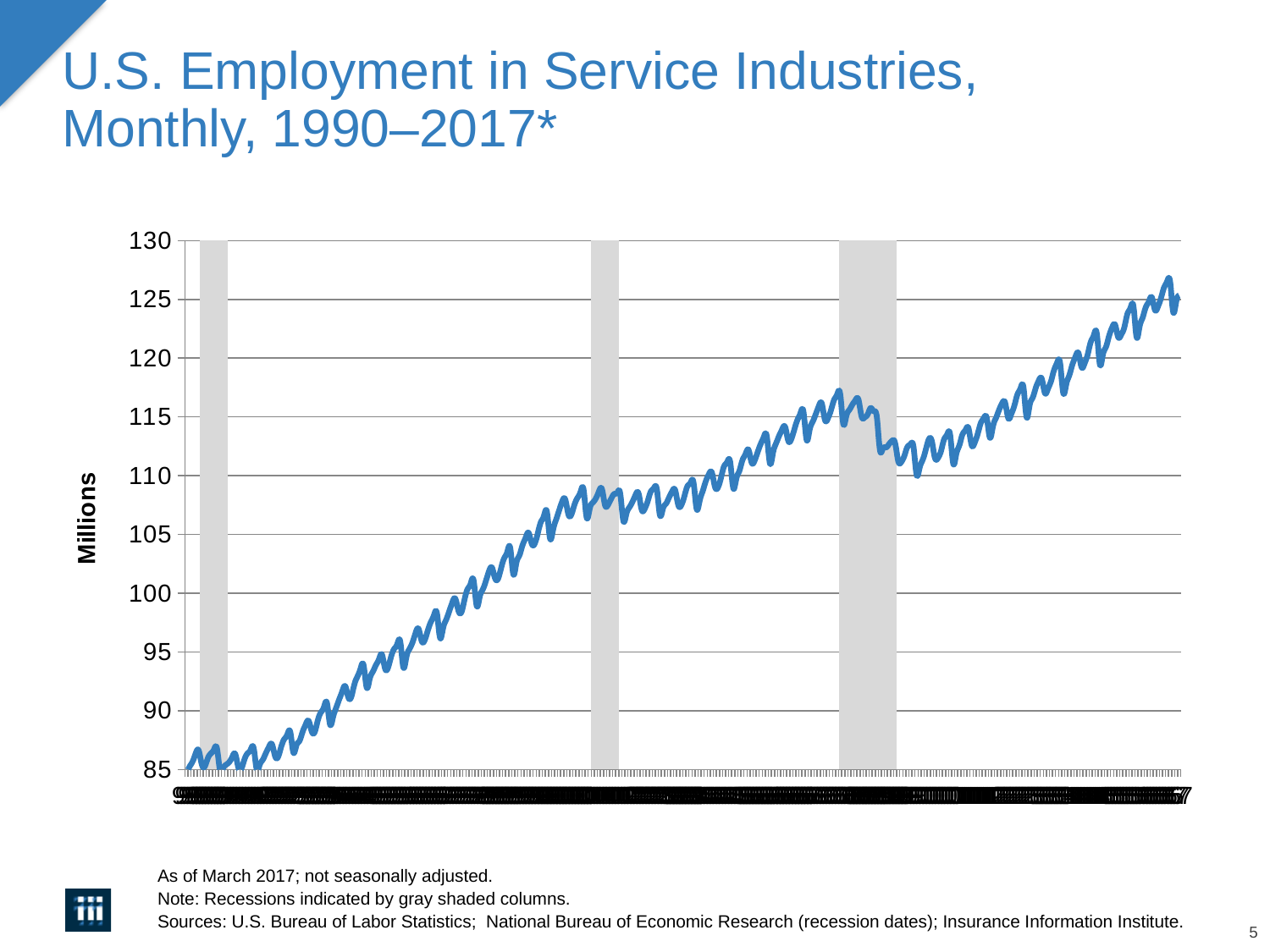
Is the value at the end of the series (far right of the chart) greater or less than 120? greater Is the value at the end of the series greater or less than the value at the start of the series? greater What is the highest value shown on the vertical axis? 130 Is the highest point reached by the line greater or less than 125? greater Is the value at the start of the series (far left of the chart) greater or less than 90? less What is the title of the chart on the slide? U.S. Employment in Service Industries, Monthly, 1990–2017* What kind of chart is shown on the slide? line chart What is the label on the vertical axis of the chart? Millions Overall, do the values rise or fall from left to right along the x axis? rise How many gray shaded recession columns appear on the chart? 3